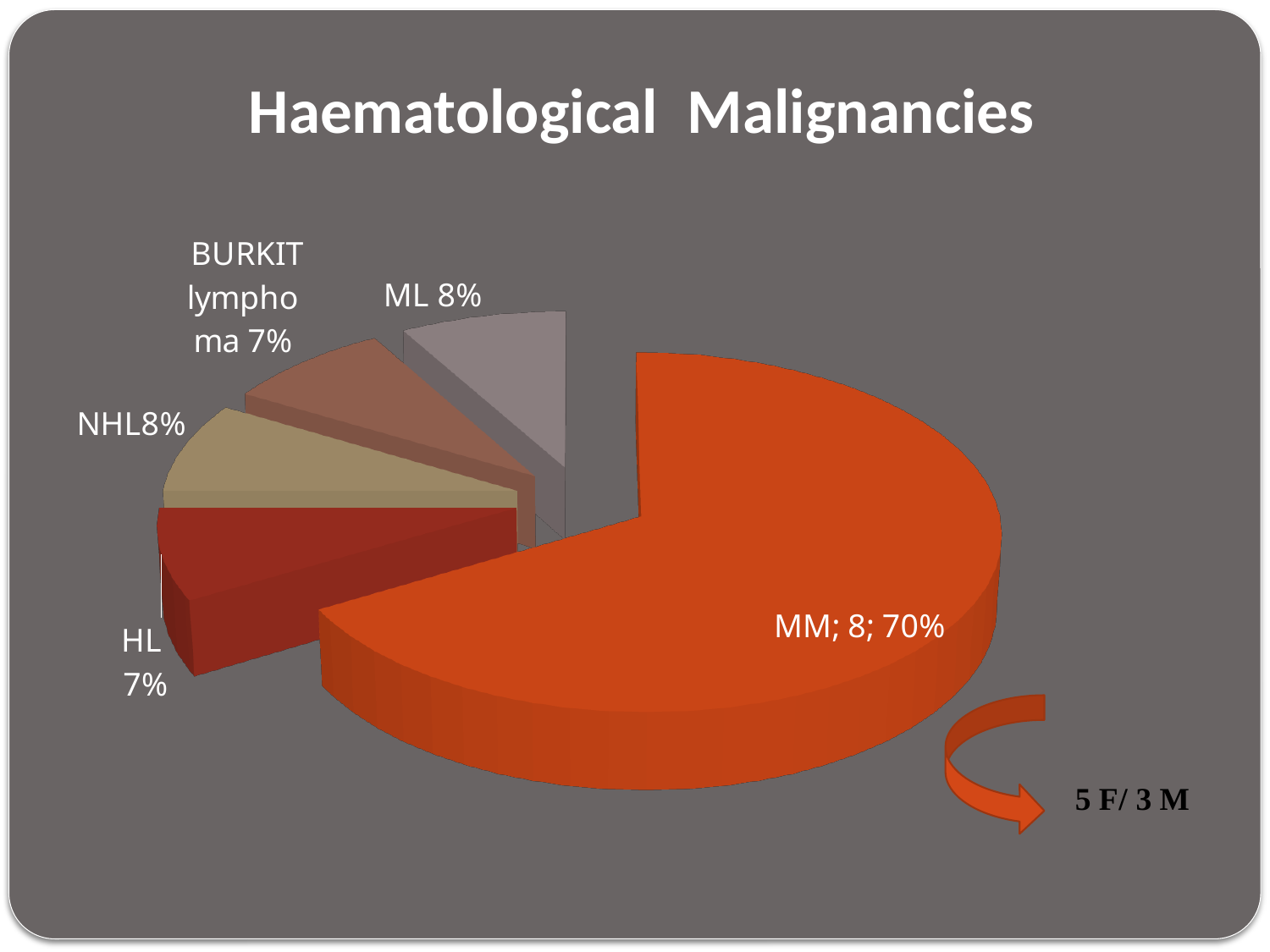
What share of the pie does MM represent? 70% What is the title of the chart? Haematological Malignancies Which category has the largest slice of the pie? MM What is the difference in percentage points between the MM share and the ML share? 62% Which is larger, the share for MM or the share for ML? MM How many slices does the pie chart have? 5 What kind of chart is shown on the slide? pie chart What share of the pie does BURKIT lymphoma represent? 7% What share of the pie does ML represent? 8% What count is shown in the data label for MM? 8